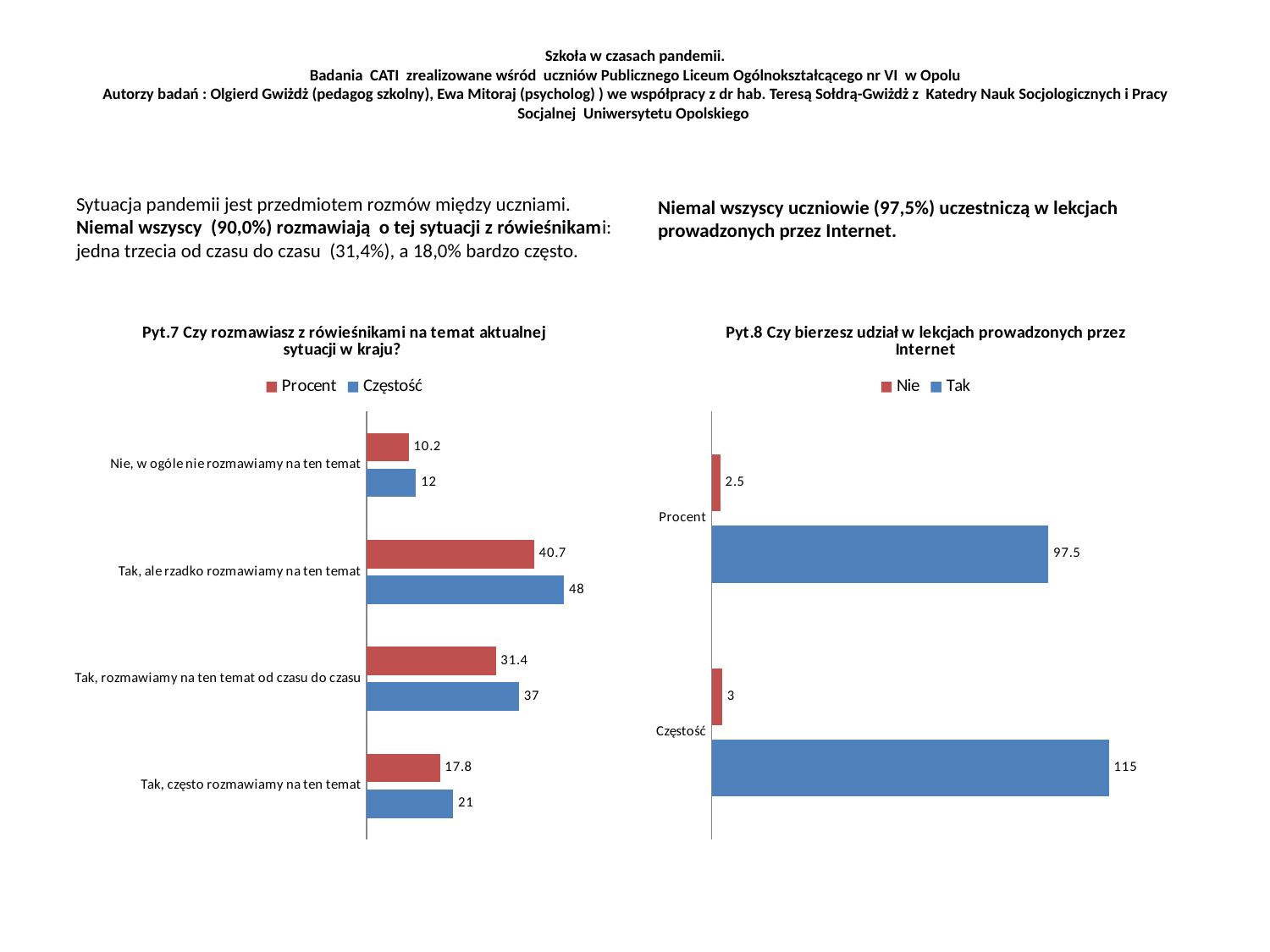
In the chart 'Pyt.7 Czy rozmawiasz z rówieśnikami na temat aktualnej sytuacji w kraju?', what is the Częstość value for 'Nie, w ogóle nie rozmawiamy na ten temat'? 12 In the chart 'Pyt.8 Czy bierzesz udział w lekcjach prowadzonych przez Internet', what is the Tak value for Procent? 97.5 In the chart 'Pyt.7 Czy rozmawiasz z rówieśnikami na temat aktualnej sytuacji w kraju?', how many series does the legend list? 2 In the chart 'Pyt.7 Czy rozmawiasz z rówieśnikami na temat aktualnej sytuacji w kraju?', how many categories are shown? 4 What kind of chart is 'Pyt.8 Czy bierzesz udział w lekcjach prowadzonych przez Internet'? Bar chart In the chart 'Pyt.8 Czy bierzesz udział w lekcjach prowadzonych przez Internet', which colour represents the Nie series? Red In the chart 'Pyt.7 Czy rozmawiasz z rówieśnikami na temat aktualnej sytuacji w kraju?', what is the difference in Częstość between 'Tak, ale rzadko rozmawiamy na ten temat' and 'Tak, rozmawiamy na ten temat od czasu do czasu'? 11 In the chart 'Pyt.8 Czy bierzesz udział w lekcjach prowadzonych przez Internet', which is larger for Częstość: Tak or Nie? Tak In the chart 'Pyt.7 Czy rozmawiasz z rówieśnikami na temat aktualnej sytuacji w kraju?', what is the Procent value for 'Tak, ale rzadko rozmawiamy na ten temat'? 40.7 In the chart 'Pyt.8 Czy bierzesz udział w lekcjach prowadzonych przez Internet', what is the Nie value for Częstość? 3 In the chart 'Pyt.7 Czy rozmawiasz z rówieśnikami na temat aktualnej sytuacji w kraju?', which category has the lowest Procent value? Nie, w ogóle nie rozmawiamy na ten temat In the chart 'Pyt.7 Czy rozmawiasz z rówieśnikami na temat aktualnej sytuacji w kraju?', which category has the highest Częstość value? Tak, ale rzadko rozmawiamy na ten temat